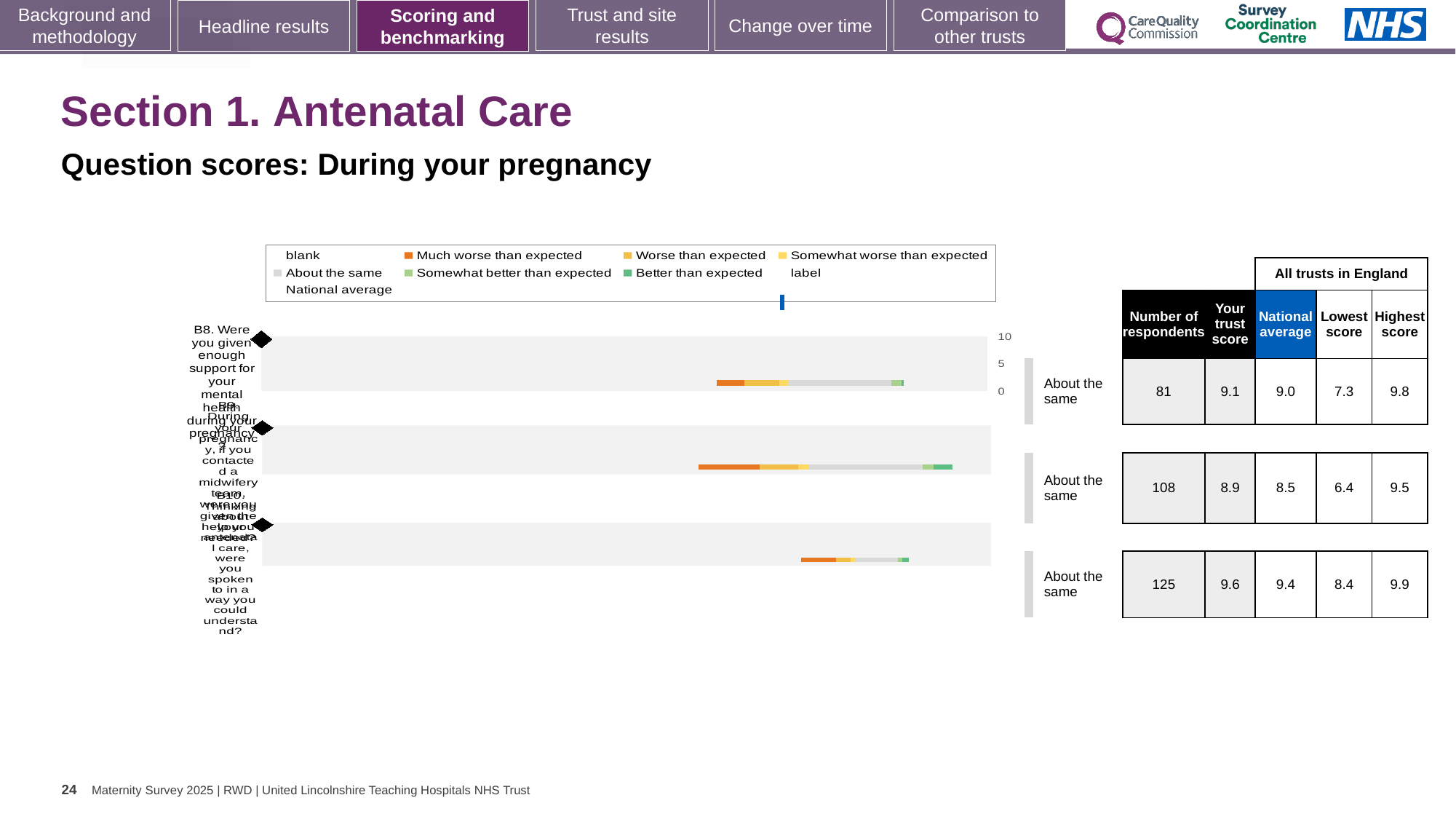
What benchmark category is shown next to each of the three bars? About the same How many question bars are plotted in the chart? 3 Which bar has the lowest 'Lowest score' value? the second bar (108 respondents) For the second bar, which is larger: 'Your trust score' or the National average? Your trust score How many respondents are listed for the first bar (B8)? 81 What is the Highest score for the third bar (125 respondents)? 9.9 What is the chart's legend entry shown in dark orange? Much worse than expected What kind of chart is shown on the slide? bar chart For the third bar, what is the difference between 'Your trust score' and the National average? 0.2 Which bar has the highest 'Your trust score'? the third bar (125 respondents) What is the 'Your trust score' for the first bar (B8, support for your mental health during pregnancy)? 9.1 What is the National average for the second bar (108 respondents)? 8.5